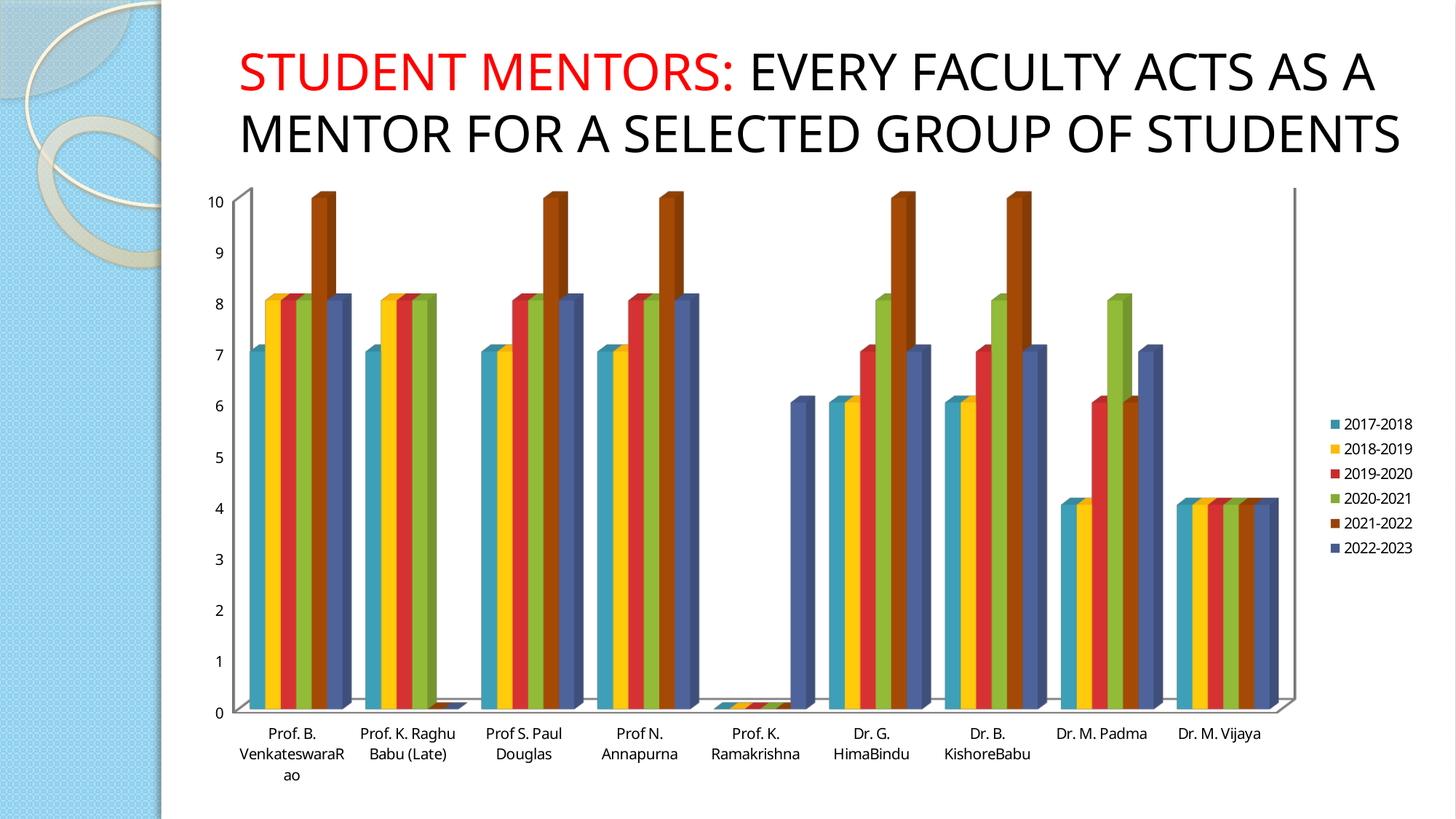
Which faculty member has the lowest 2017-2018 value? Prof. K. Ramakrishna Is the 2022-2023 value for Prof. K. Ramakrishna greater or less than 5? greater Is the 2021-2022 value for Prof. B. VenkateswaraRao greater or less than 9? greater Is the 2019-2020 value for Dr. M. Vijaya greater or less than 5? less What is the first series listed in the legend? 2017-2018 How many faculty members (categories) are shown on the x axis? 9 What kind of chart is shown on the slide? bar chart How many series does the legend list? 6 Which is larger: the 2021-2022 value for Prof S. Paul Douglas or the 2021-2022 value for Dr. M. Padma? Prof S. Paul Douglas For Dr. M. Padma, which is larger: the 2020-2021 value or the 2017-2018 value? 2020-2021 For Dr. G. HimaBindu, which series has the highest value? 2021-2022